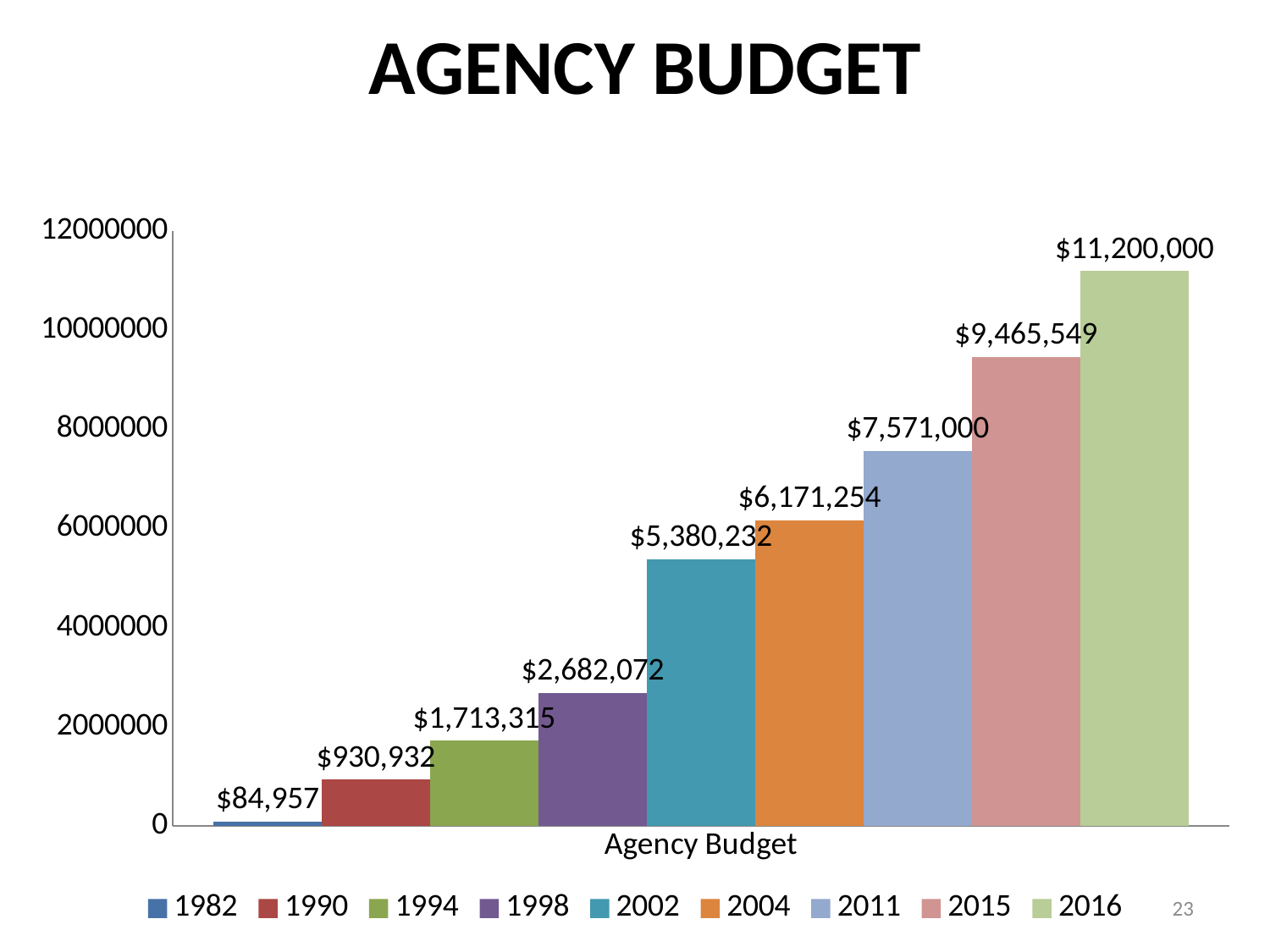
How many years are shown in the chart? 9 Is the value for 2011 greater or less than 8000000? less What is the agency budget for 2015? $9,465,549 What is the agency budget for 2002? $5,380,232 Which is larger, the budget for 2004 or the budget for 2011? 2011 What is the agency budget for 1982? $84,957 What is the difference between the 2016 budget and the 2015 budget? $1,734,451 What is the difference between the 1998 budget and the 1994 budget? $968,757 Which year has the lowest agency budget? 1982 Which year has the highest agency budget? 2016 What kind of chart is shown on the slide? bar chart Do the budget values rise or fall from 1982 to 2016? rise